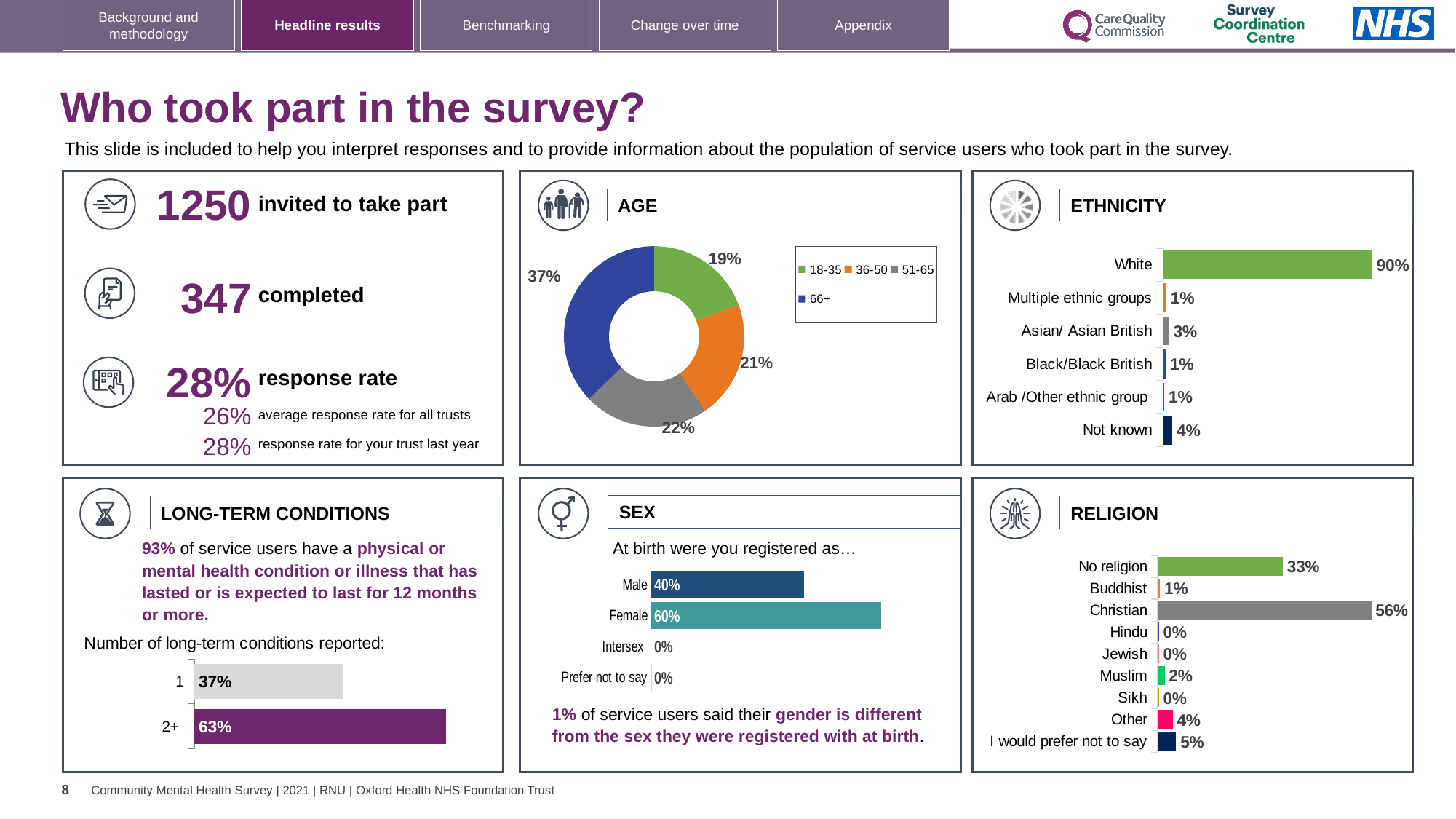
How many categories are shown in the RELIGION chart? 9 In the RELIGION chart, what is the value for I would prefer not to say? 5% In the AGE chart, what percentage of respondents were aged 66+? 37% What kind of chart is the AGE chart? Donut (pie) chart In the RELIGION chart, which category has the highest value? Christian In the SEX chart, which is larger, Male or Female? Female How many age groups does the legend of the AGE chart list? 4 In the ETHNICITY chart, which category has the highest value? White In the ETHNICITY chart, what is the value for Asian/ Asian British? 3% In the SEX chart, what is the difference between Female and Male? 20% In the LONG-TERM CONDITIONS chart, what percentage reported 2+ conditions? 63% In the ETHNICITY chart, what is the difference between White and Not known? 86%